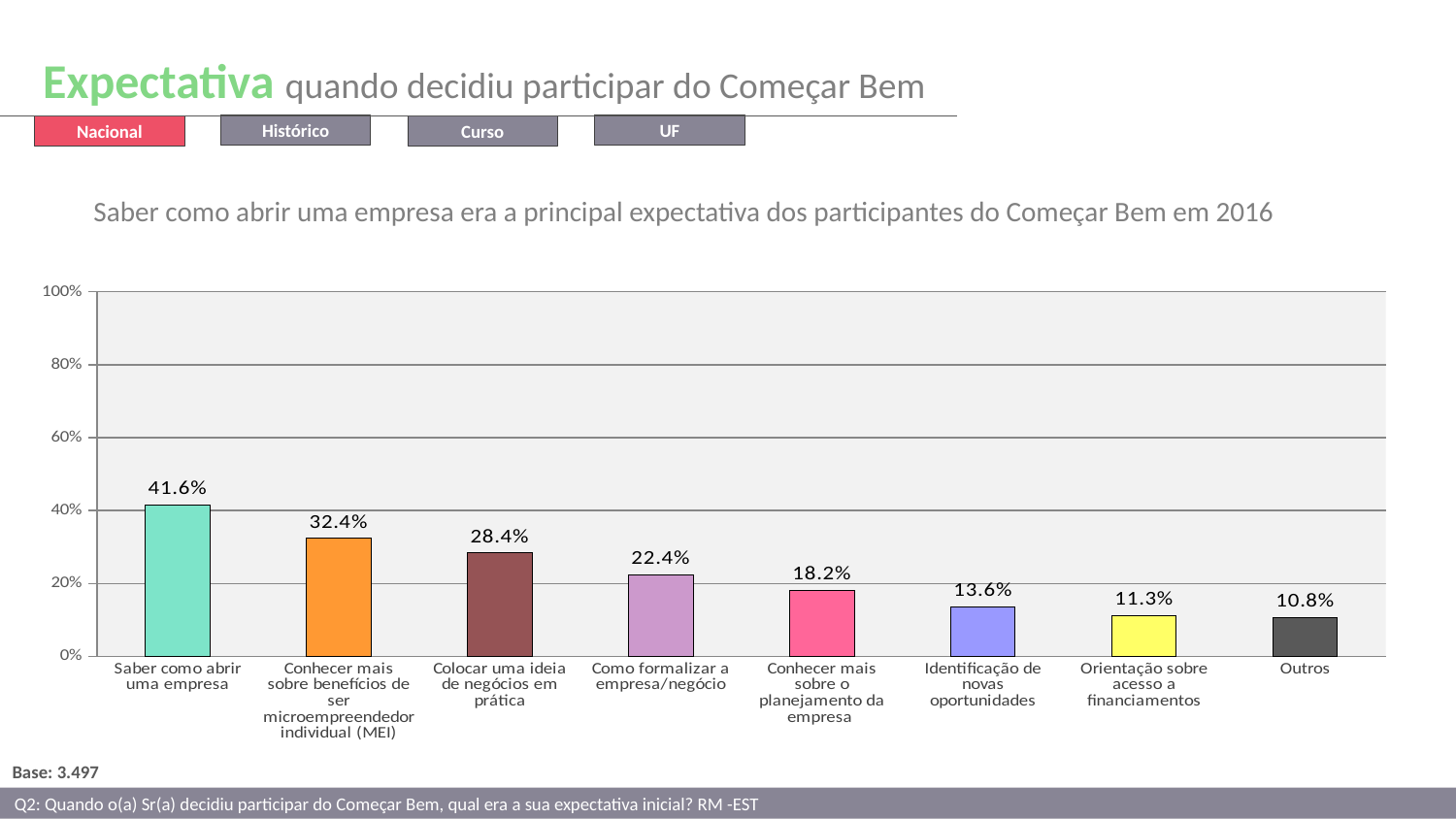
What kind of chart is shown on the slide? bar chart What is the value for "Saber como abrir uma empresa"? 41.6% What is the value for "Como formalizar a empresa/negócio"? 22.4% Do the values rise or fall from left to right along the x axis? fall What is the value for "Outros"? 10.8% What is the base (sample size) shown on the slide? 3.497 What is the difference between "Saber como abrir uma empresa" and "Conhecer mais sobre benefícios de ser microempreendedor individual (MEI)"? 9.2% Which category has the highest value? Saber como abrir uma empresa How many categories are shown on the chart? 8 Which is larger: "Colocar uma ideia de negócios em prática" or "Conhecer mais sobre o planejamento da empresa"? Colocar uma ideia de negócios em prática Which category has the lowest value? Outros Is the value for "Identificação de novas oportunidades" greater or less than 20%? less